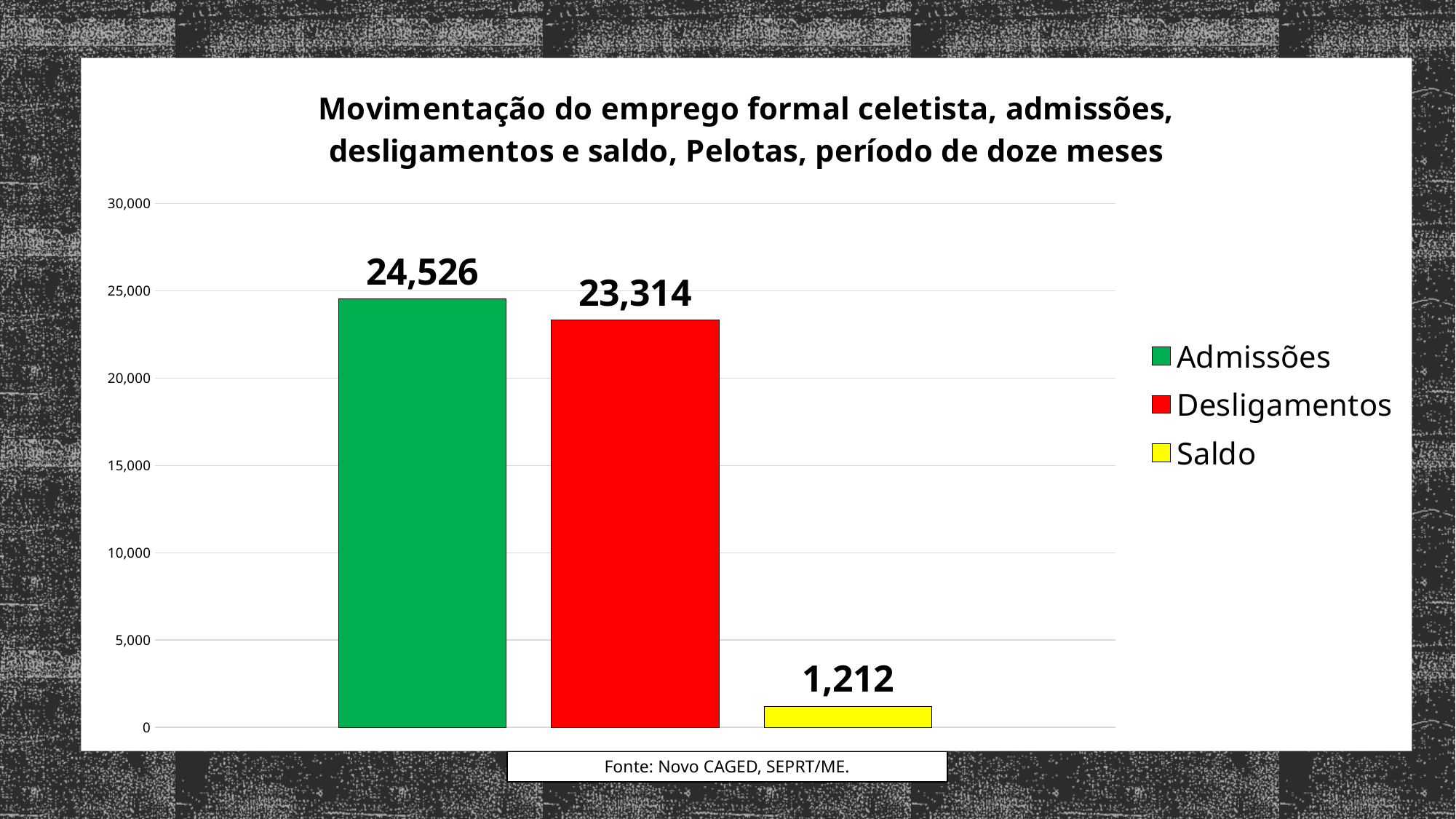
Is the value for Desligamentos greater or less than 25,000? less How many series does the legend list? 3 Which series has the lowest value? Saldo What is the difference between Admissões and Desligamentos? 1,212 What is the value for Desligamentos? 23,314 What colour is the bar for Saldo? yellow What is the value for Admissões? 24,526 Which is larger, Admissões or Desligamentos? Admissões What is the value for Saldo? 1,212 Which series has the highest value? Admissões What kind of chart is shown on the slide? bar chart How many bars are plotted in the chart? 3